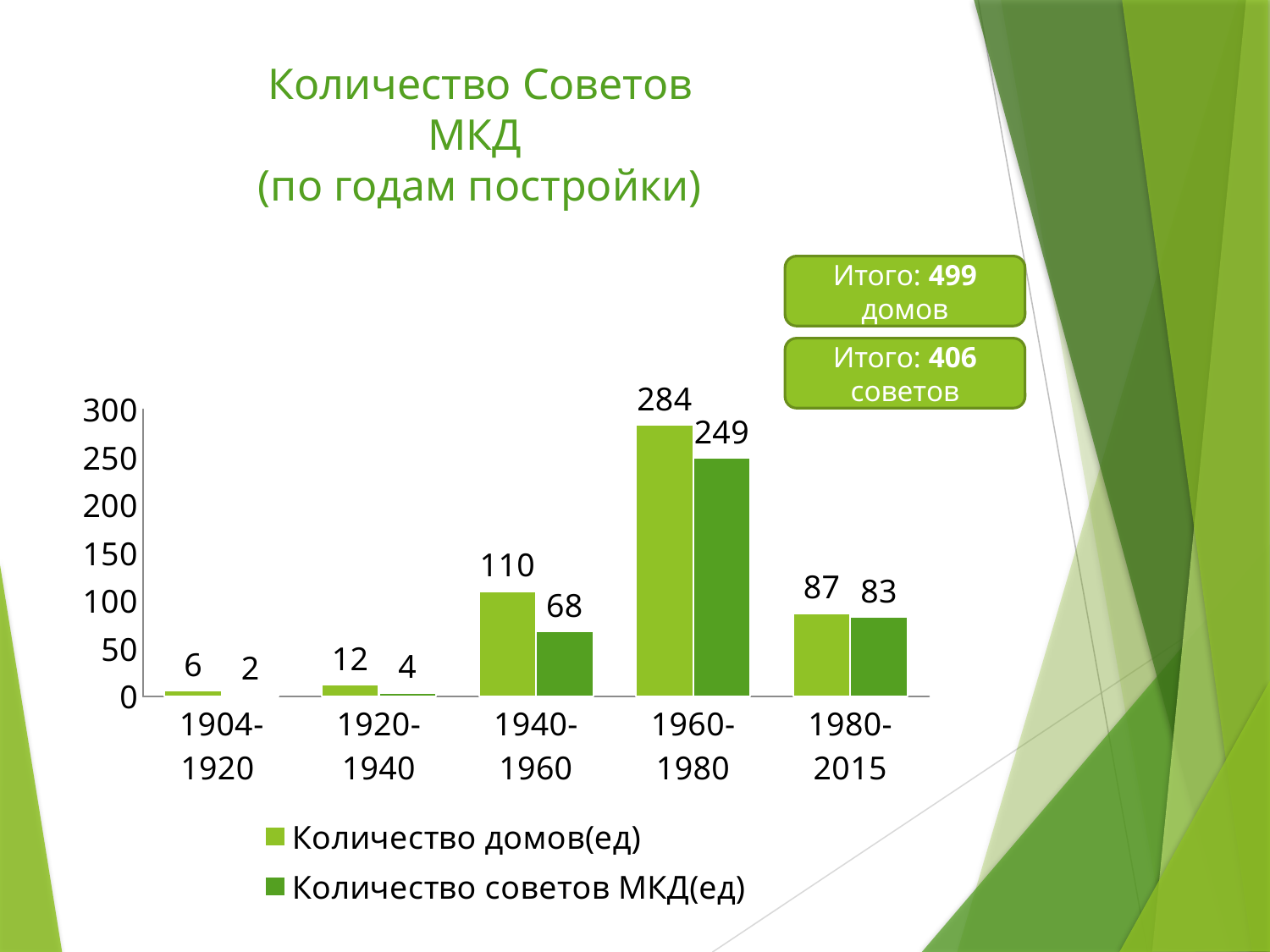
What is the title of the chart? Количество Советов МКД (по годам постройки) What kind of chart is shown on the slide? bar chart How many periods are shown on the x axis? 5 What is the value of Количество советов МКД(ед) for 1904-1920? 2 Which period has the lowest value for Количество советов МКД(ед)? 1904-1920 What is the value of Количество советов МКД(ед) for 1940-1960? 68 What is the value of Количество домов(ед) for 1960-1980? 284 What is the difference between Количество домов(ед) and Количество советов МКД(ед) for 1960-1980? 35 How many series does the legend list? 2 What is the difference between Количество домов(ед) for 1940-1960 and for 1980-2015? 23 Which period has the highest value for Количество домов(ед)? 1960-1980 Which is larger: Количество советов МКД(ед) for 1940-1960 or for 1980-2015? 1980-2015